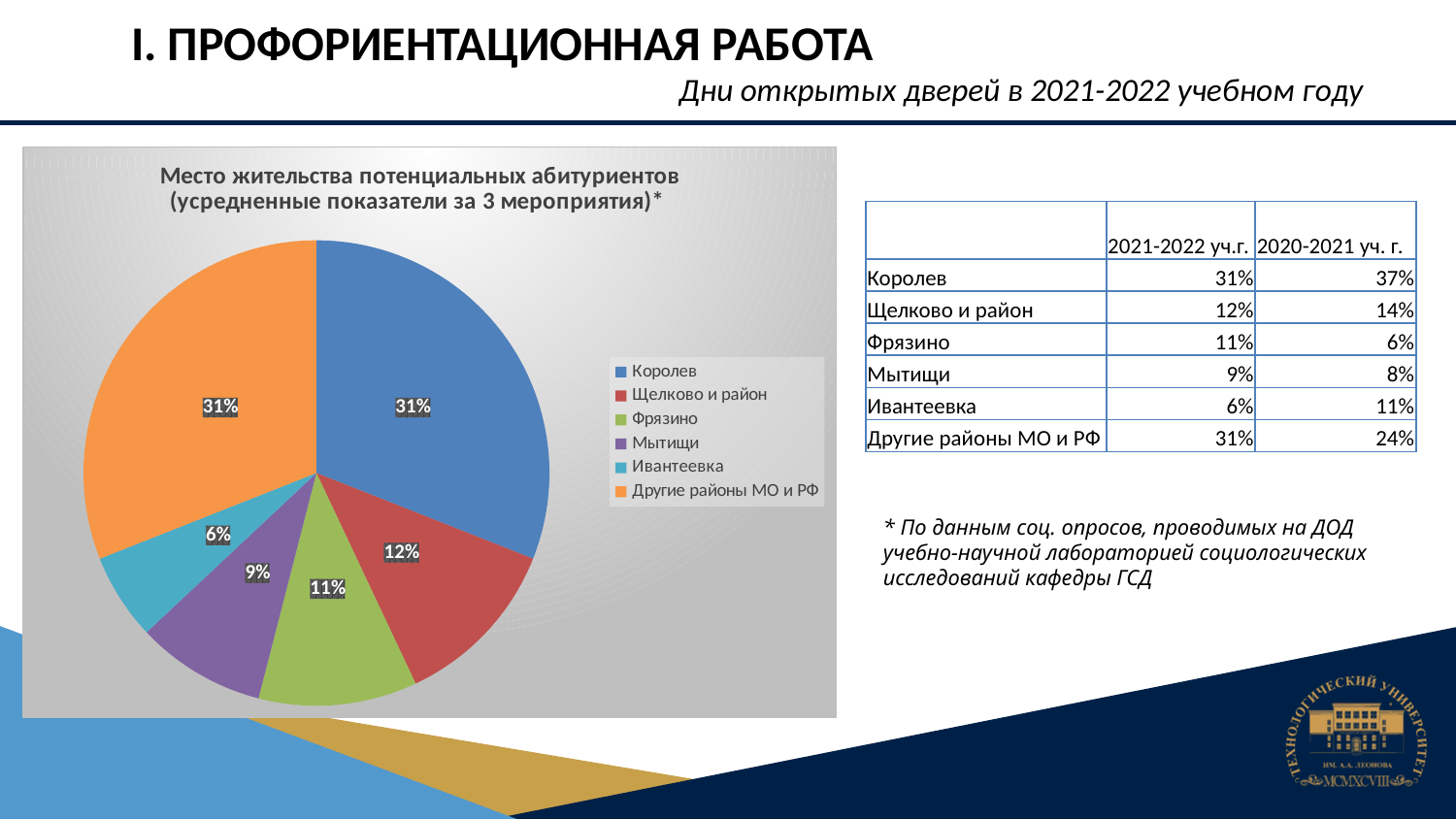
What kind of chart is shown on the slide? pie chart What is the share for Королев in the pie chart? 31% What is the share for Другие районы МО и РФ in the pie chart? 31% Which category has the smallest slice in the pie chart? Ивантеевка How many categories are shown in the pie chart? 6 What is the difference between the shares of Щелково и район and Ивантеевка in the pie chart? 6% What is the share for Фрязино in the pie chart? 11% What is the share for Мытищи in the pie chart? 9% What is the title of the pie chart? Место жительства потенциальных абитуриентов (усредненные показатели за 3 мероприятия)* Which slice is larger in the pie chart: Фрязино or Мытищи? Фрязино What is the share for Щелково и район in the pie chart? 12% What colour is the slice for Ивантеевка in the pie chart? light blue